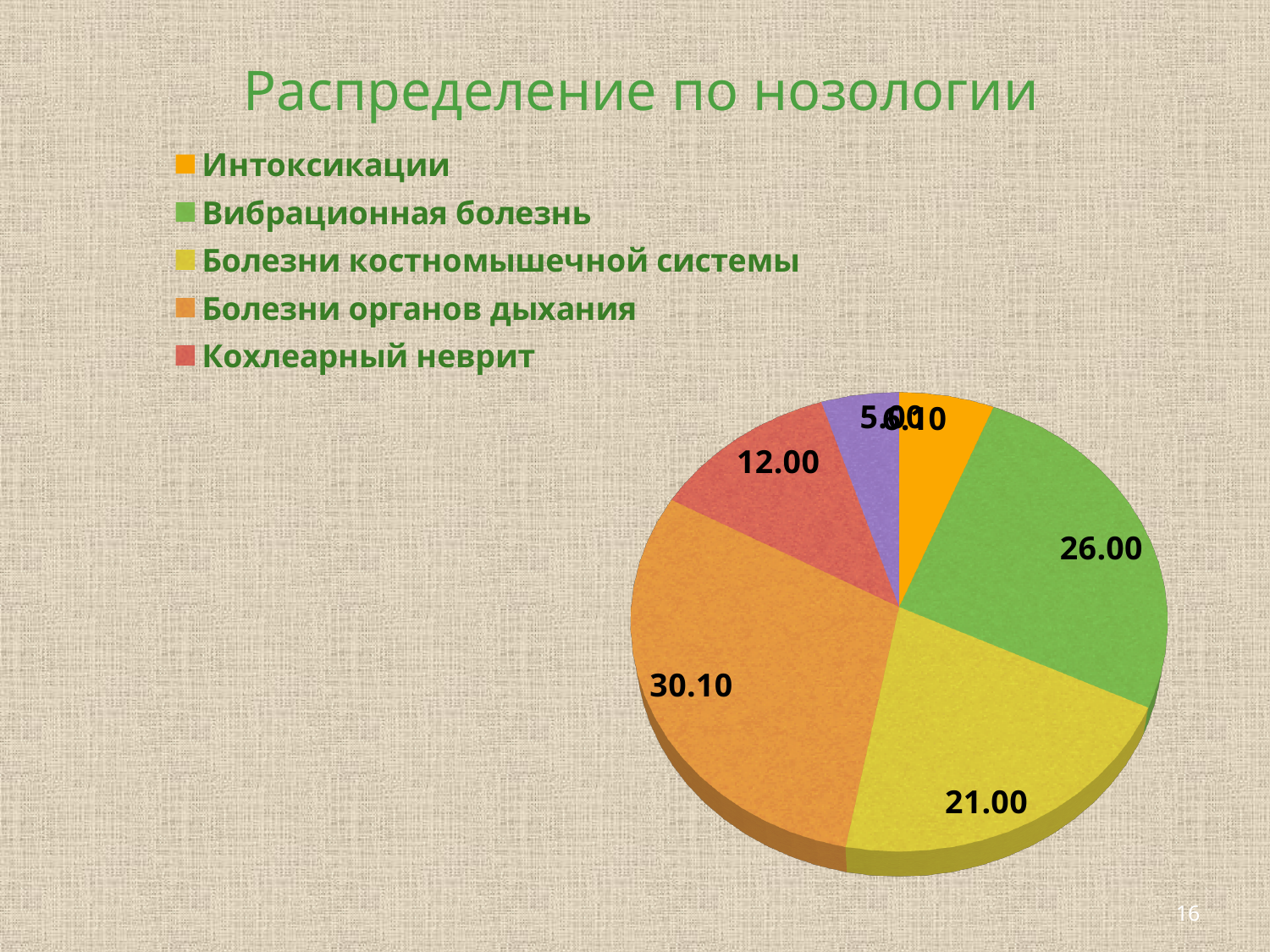
What is the value for Вибрационная болезнь? 26.00 What is the value for Болезни костномышечной системы? 21.00 Which category has the largest slice of the pie? Болезни органов дыхания What is the difference between the values for Болезни органов дыхания and Вибрационная болезнь? 4.10 How many entries does the legend list? 5 What is the difference between the values for Вибрационная болезнь and Болезни костномышечной системы? 5.00 What is the value for Кохлеарный неврит? 12.00 What kind of chart is shown on the slide? pie chart What is the title of the slide's chart? Распределение по нозологии What is the difference between the values for Болезни костномышечной системы and Кохлеарный неврит? 9.00 What is the value for Болезни органов дыхания? 30.10 Which is larger, Вибрационная болезнь or Болезни костномышечной системы? Вибрационная болезнь